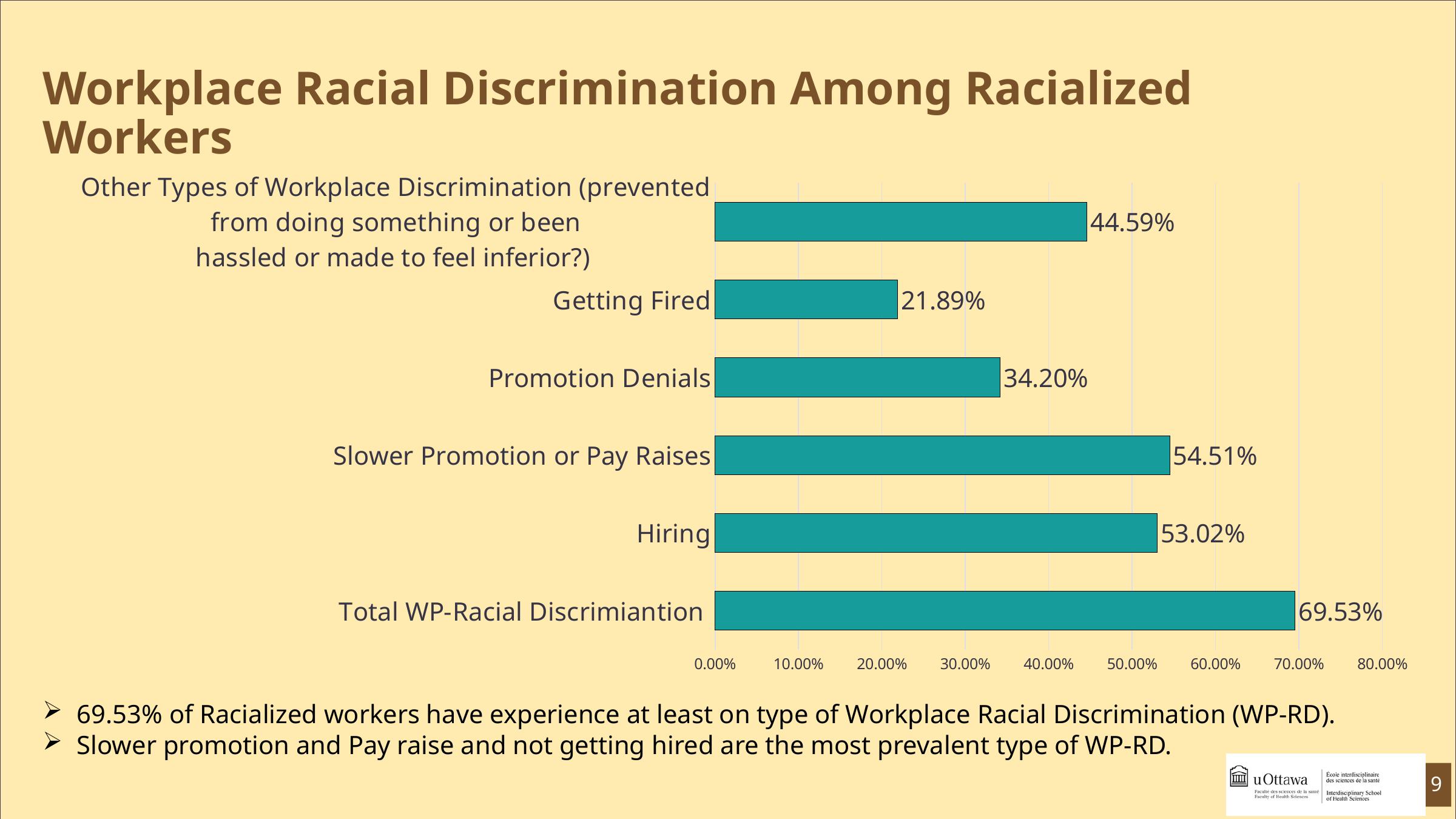
How many categories are shown in the chart? 6 What is the difference between the values for Promotion Denials and Getting Fired? 12.31% Which category has the highest value? Total WP-Racial Discrimiantion Is the value for Total WP-Racial Discrimiantion greater or less than 60.00%? greater What is the value for Promotion Denials? 34.20% Which is larger, the value for Promotion Denials or the value for Getting Fired? Promotion Denials What is the value for Hiring? 53.02% What kind of chart is shown on the slide? bar chart What is the difference between the values for Slower Promotion or Pay Raises and Hiring? 1.49% Which category has the lowest value? Getting Fired What is the value for Slower Promotion or Pay Raises? 54.51% What is the value for Getting Fired? 21.89%